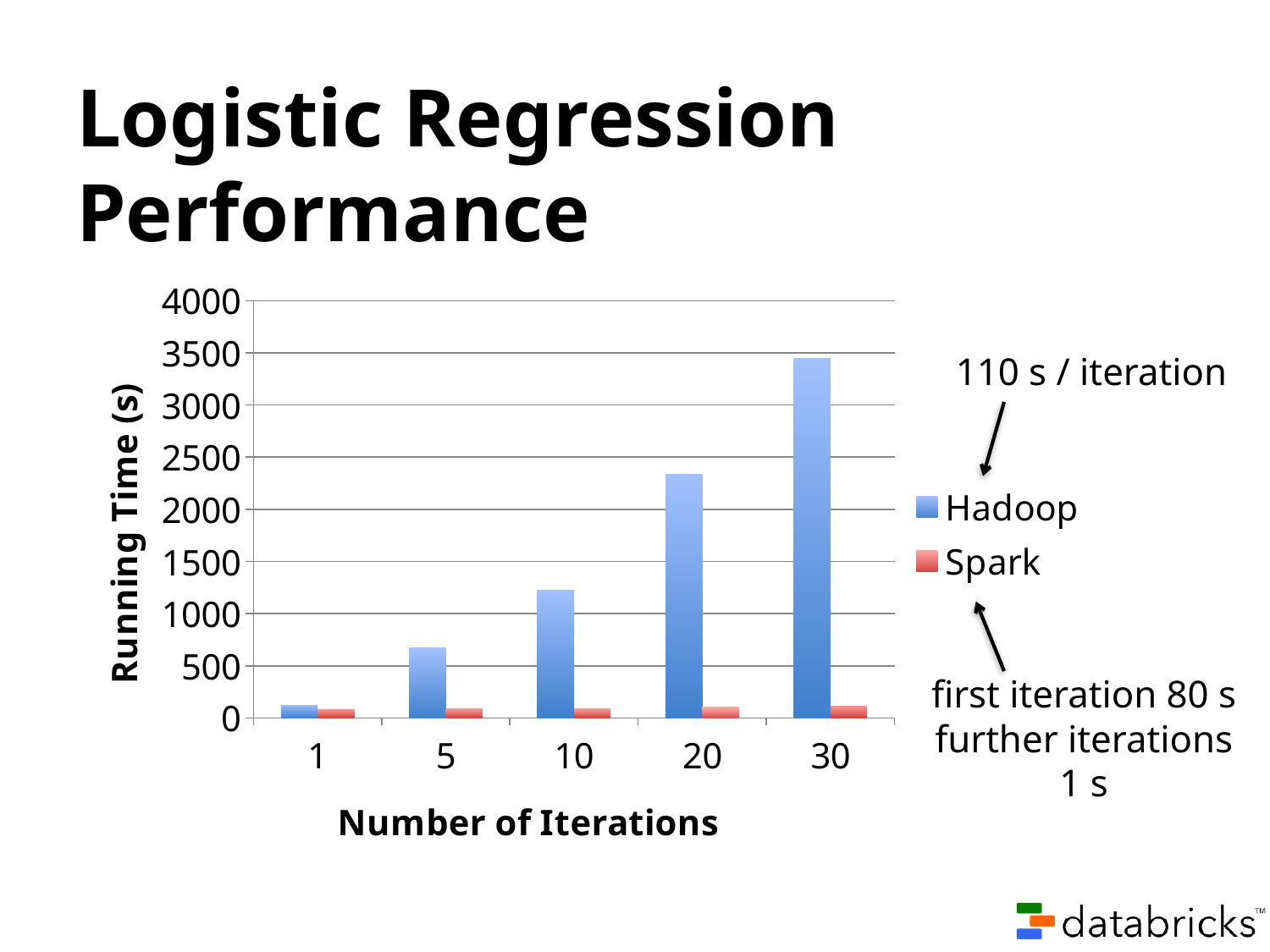
How many series does the legend list? 2 Is the Hadoop running time for 5 iterations greater or less than 1000? less What kind of chart is shown on the slide? bar chart How many iteration counts are shown on the x axis? 5 Is the Hadoop running time for 30 iterations greater or less than 3000? greater What is the title of the y axis? Running Time (s) At 20 iterations, which has the larger running time, Hadoop or Spark? Hadoop Is the Hadoop running time for 20 iterations greater or less than 2000? greater Does the Hadoop running time rise or fall as the number of iterations increases? rise At which number of iterations is the Hadoop running time lowest? 1 At which number of iterations is the Hadoop running time highest? 30